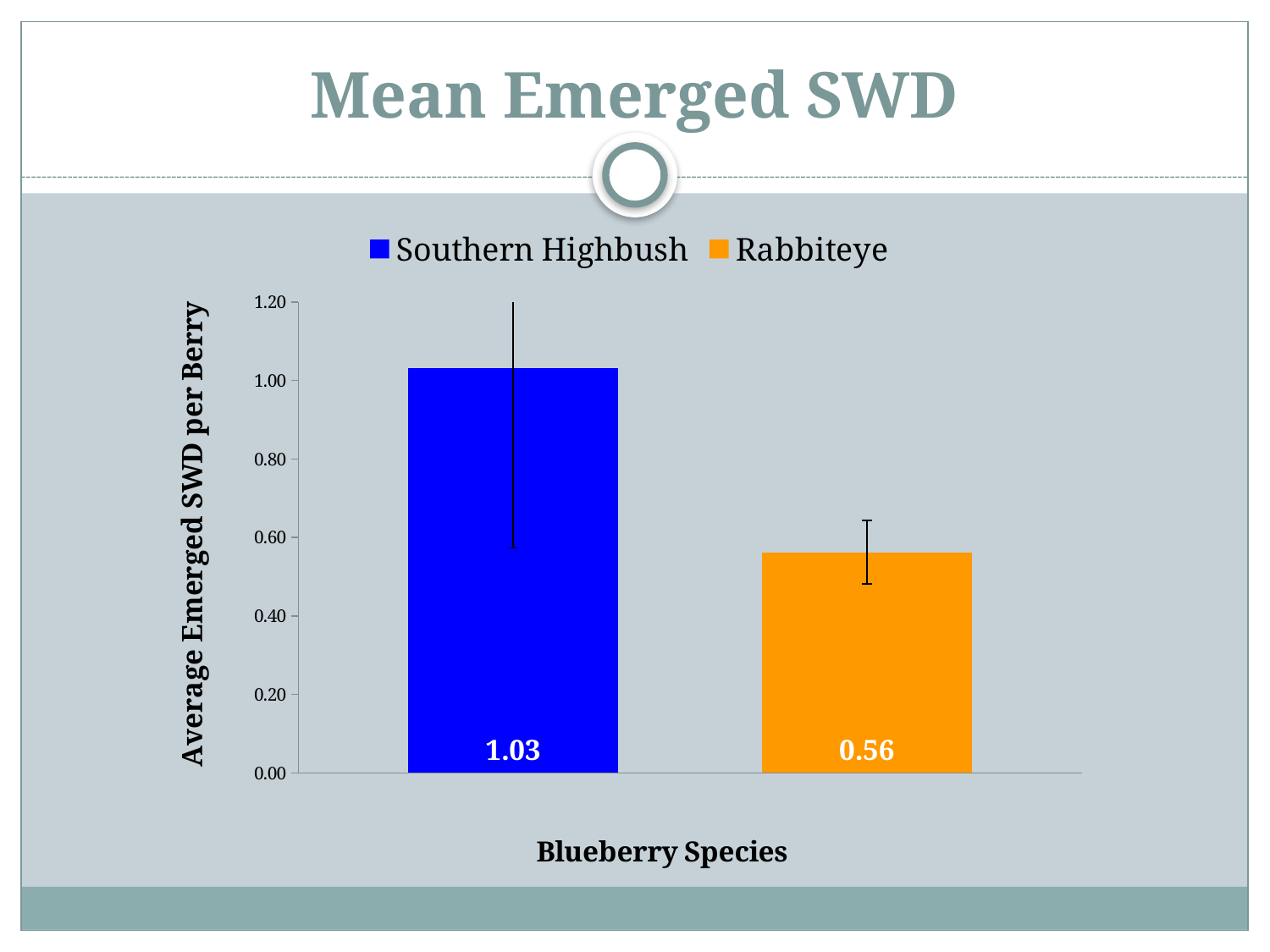
Is the value for Southern Highbush greater or less than 1.00? greater What is the difference in average emerged SWD per berry between Southern Highbush and Rabbiteye? 0.47 How many bars are plotted in the chart? 2 Which blueberry species has the higher average emerged SWD per berry? Southern Highbush What kind of chart is shown on the slide? Bar chart Is the value for Rabbiteye greater or less than 0.60? less What is the average emerged SWD per berry for Southern Highbush? 1.03 Which blueberry species has the lower average emerged SWD per berry? Rabbiteye What is the average emerged SWD per berry for Rabbiteye? 0.56 How many entries does the legend list? 2 What is the label of the y axis? Average Emerged SWD per Berry Is the average emerged SWD per berry larger for Southern Highbush or Rabbiteye? Southern Highbush